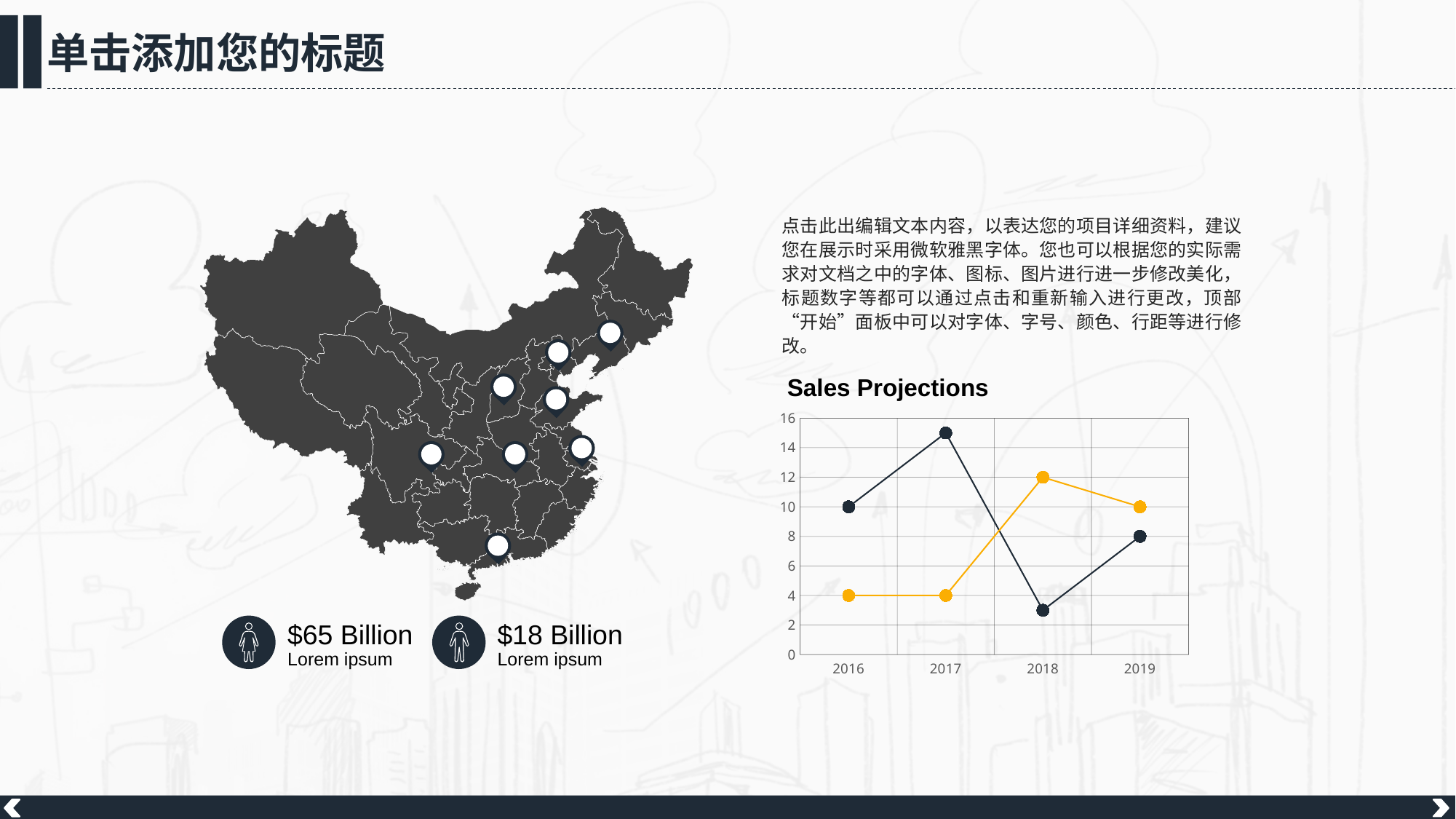
In the Sales Projections chart, what is the value of the orange line in 2018? 12 In the Sales Projections chart, in which year does the dark line reach its lowest value? 2018 In the Sales Projections chart, in which year does the dark line reach its highest value? 2017 How many lines (series) are plotted in the Sales Projections chart? 2 How many years are shown on the x axis of the Sales Projections chart? 4 What kind of chart is the Sales Projections chart? line chart In the Sales Projections chart, what is the value of the dark line in 2016? 10 In the Sales Projections chart, which line has the larger value in 2018, the orange line or the dark line? the orange line In the Sales Projections chart, what is the difference between the orange line's values in 2018 and 2019? 2 In the Sales Projections chart, is the value of the dark line in 2017 greater or less than 14? greater In the Sales Projections chart, what is the value of the orange line in 2016? 4 In the Sales Projections chart, what is the value of the dark line in 2019? 8